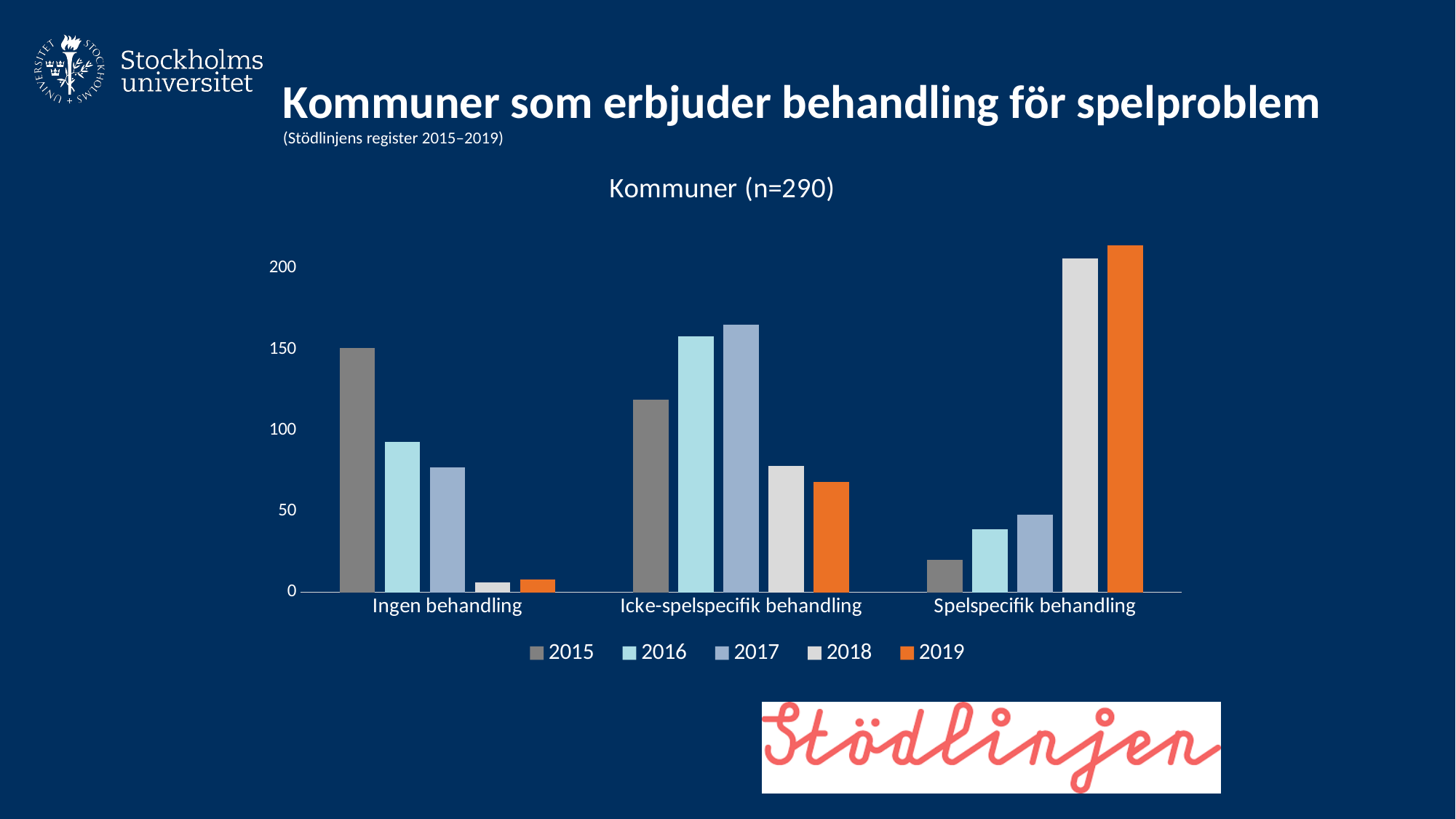
Which year has the highest value for Spelspecifik behandling? 2019 Is the value for 2019 in Ingen behandling greater or less than 50? less What kind of chart is shown on the slide? bar chart Which year has the lowest value for Ingen behandling? 2018 Is the value for 2019 in Spelspecifik behandling greater or less than 200? greater Which year has the lowest value for Spelspecifik behandling? 2015 Do the values for Ingen behandling rise or fall from 2015 to 2019? fall What is the title shown above the chart? Kommuner (n=290) How many categories are shown on the x axis of the chart? 3 How many series does the chart's legend list? 5 Which year has the highest value for Ingen behandling? 2015 For Icke-spelspecifik behandling, which is larger: the value for 2016 or the value for 2019? 2016